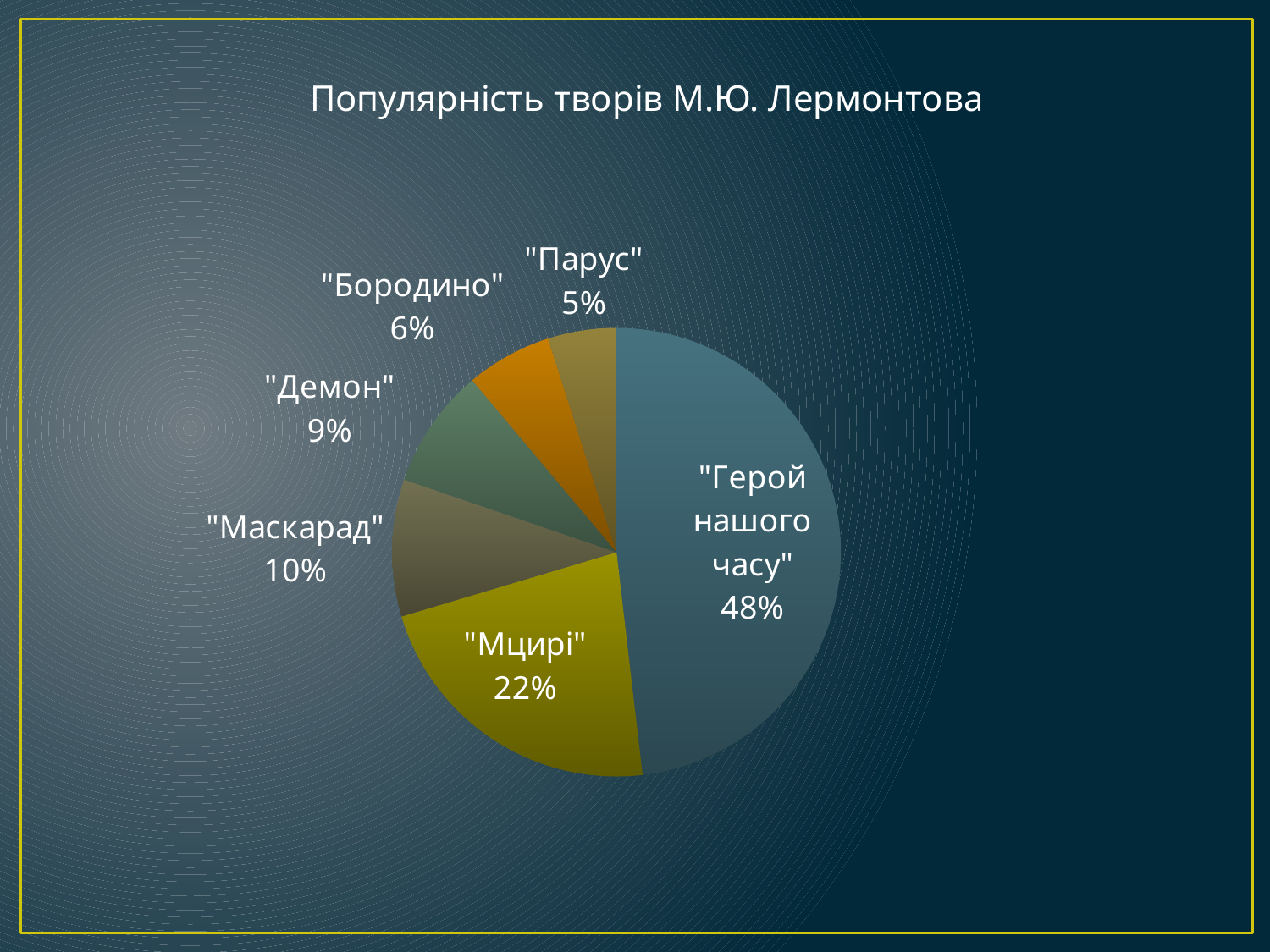
What is the value shown for "Мцирі"? 22% Which work has the largest slice of the pie? "Герой нашого часу" What is the value shown for "Маскарад"? 10% What kind of chart is shown on the slide? Pie chart What share of the pie does "Герой нашого часу" have? 48% What is the title of the chart? Популярність творів М.Ю. Лермонтова What is the value shown for "Демон"? 9% What is the difference in percentage points between "Герой нашого часу" and "Мцирі"? 26 How many works (slices) are shown in the pie chart? 6 Which is larger, the share for "Маскарад" or the share for "Демон"? "Маскарад" Which work has the smallest slice of the pie? "Парус" What is the value shown for "Бородино"? 6%